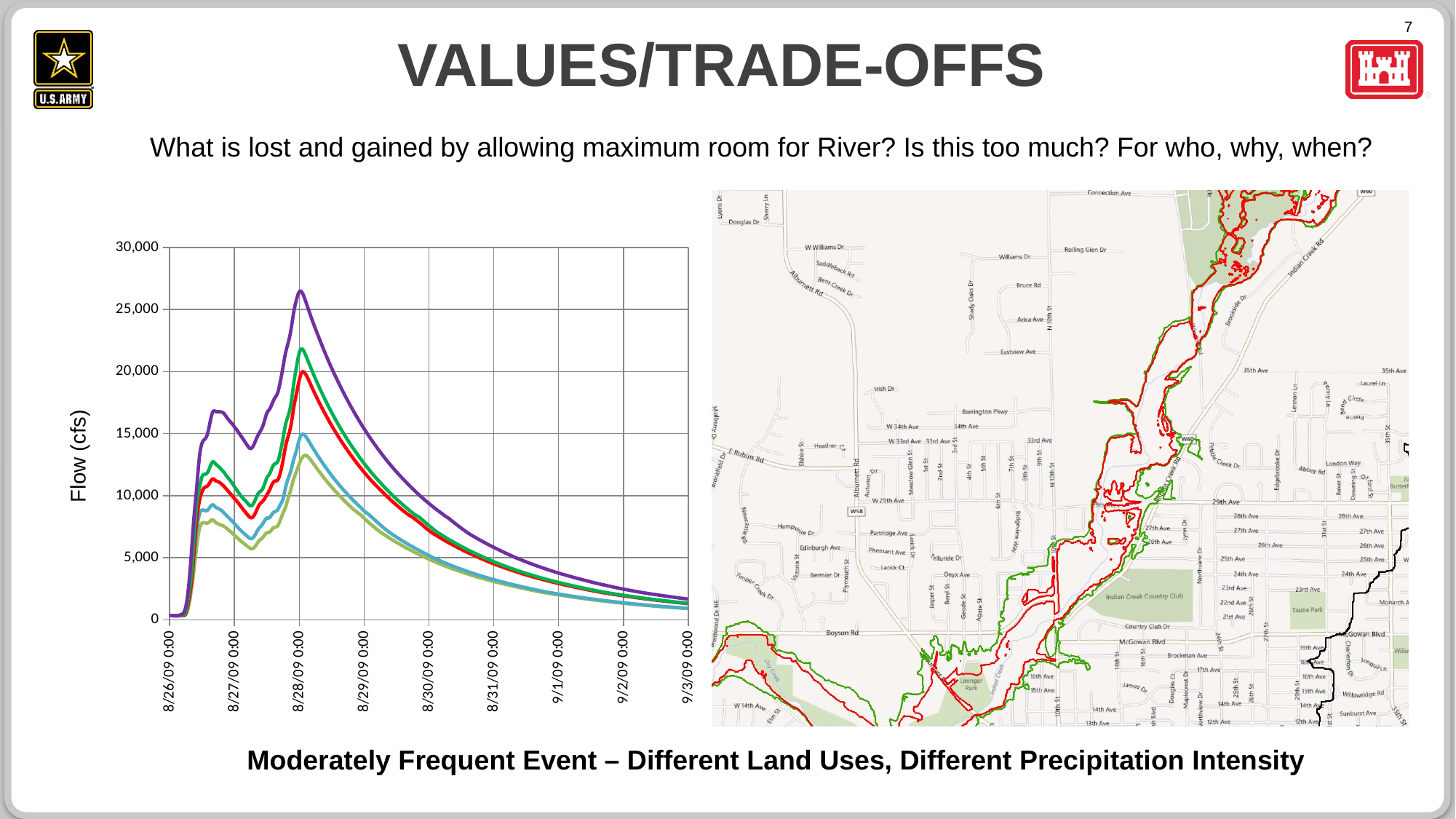
How many date labels are shown along the x axis of the flow chart? 9 Is the peak value of the purple line greater or less than 25,000? greater What kind of chart is shown on the left of the slide? line chart Is the peak value of the olive green line greater or less than 15,000? less Which coloured line has the lowest peak flow on the chart? olive green After 8/28/09 0:00, do the flow values rise or fall along the x axis? fall What is the label of the y axis on the flow chart? Flow (cfs) Around which x-axis date do all the lines reach their highest peak? 8/28/09 0:00 Which line has a higher peak flow, the purple line or the blue line? purple How many lines are plotted on the flow chart? 5 Which coloured line reaches the highest peak flow on the chart? purple Is the peak value of the green line greater or less than 20,000? greater